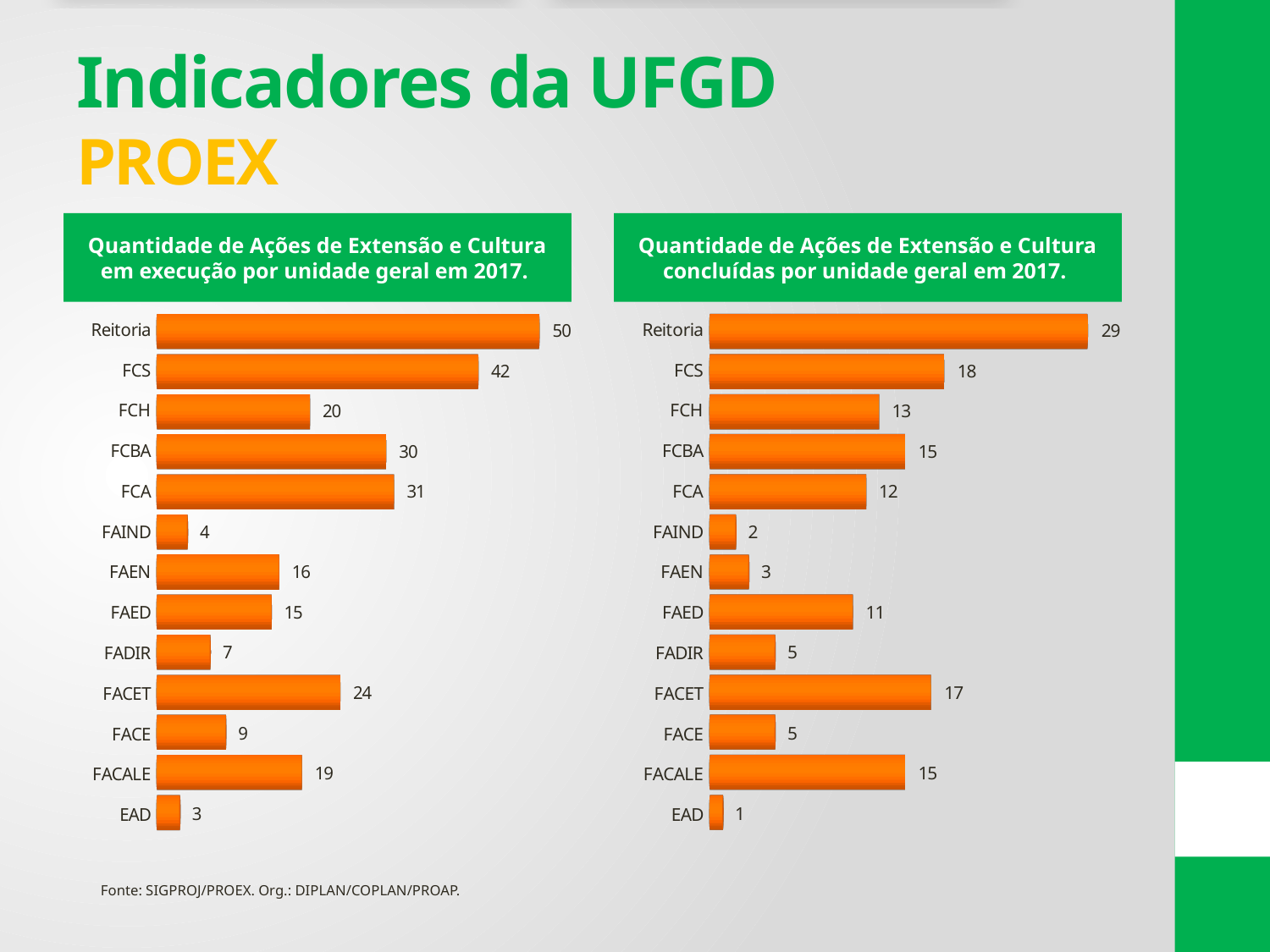
In the left chart (ações em execução), which unit has the highest value? Reitoria In the right chart (ações concluídas), which is larger, FAED or FCH? FCH What type of chart is the right chart (ações concluídas)? Bar chart In the left chart (ações em execução), which is larger, FACET or FACALE? FACET In the left chart (ações em execução), what is the difference between the values for FCA and FCBA? 1 How many units are shown in the left chart (ações em execução)? 13 In the right chart (ações concluídas), what is the difference between Reitoria and FCS? 11 In the right chart (ações concluídas), which unit has the lowest value? EAD In the right chart (ações concluídas), what is the value for FACET? 17 In the left chart (ações em execução), what is the value for FAIND? 4 In the left chart (ações em execução), what is the value for FCS? 42 What is the title of the right chart? Quantidade de Ações de Extensão e Cultura concluídas por unidade geral em 2017.